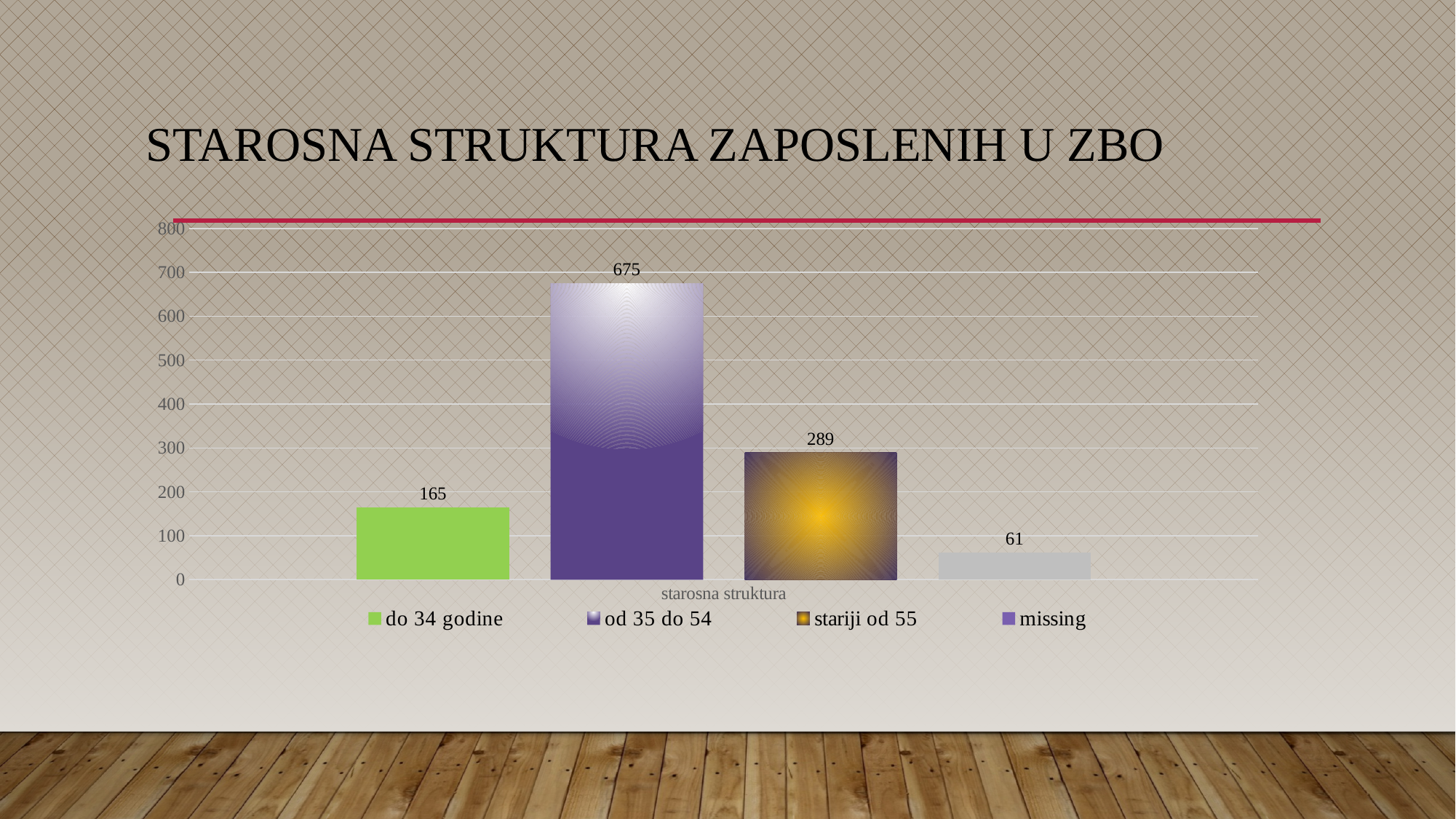
What is the value for 'missing'? 61 What is the difference between the values for 'od 35 do 54' and 'stariji od 55'? 386 What is the value for 'od 35 do 54'? 675 Which is larger, the value for 'do 34 godine' or the value for 'stariji od 55'? stariji od 55 What is the title of the slide? STAROSNA STRUKTURA ZAPOSLENIH U ZBO What kind of chart is shown on the slide? bar chart Is the value for 'do 34 godine' greater or less than 200? less How many series does the legend list? 4 What is the value for 'do 34 godine'? 165 Which series has the lowest value? missing Which series has the highest value? od 35 do 54 What is the value for 'stariji od 55'? 289